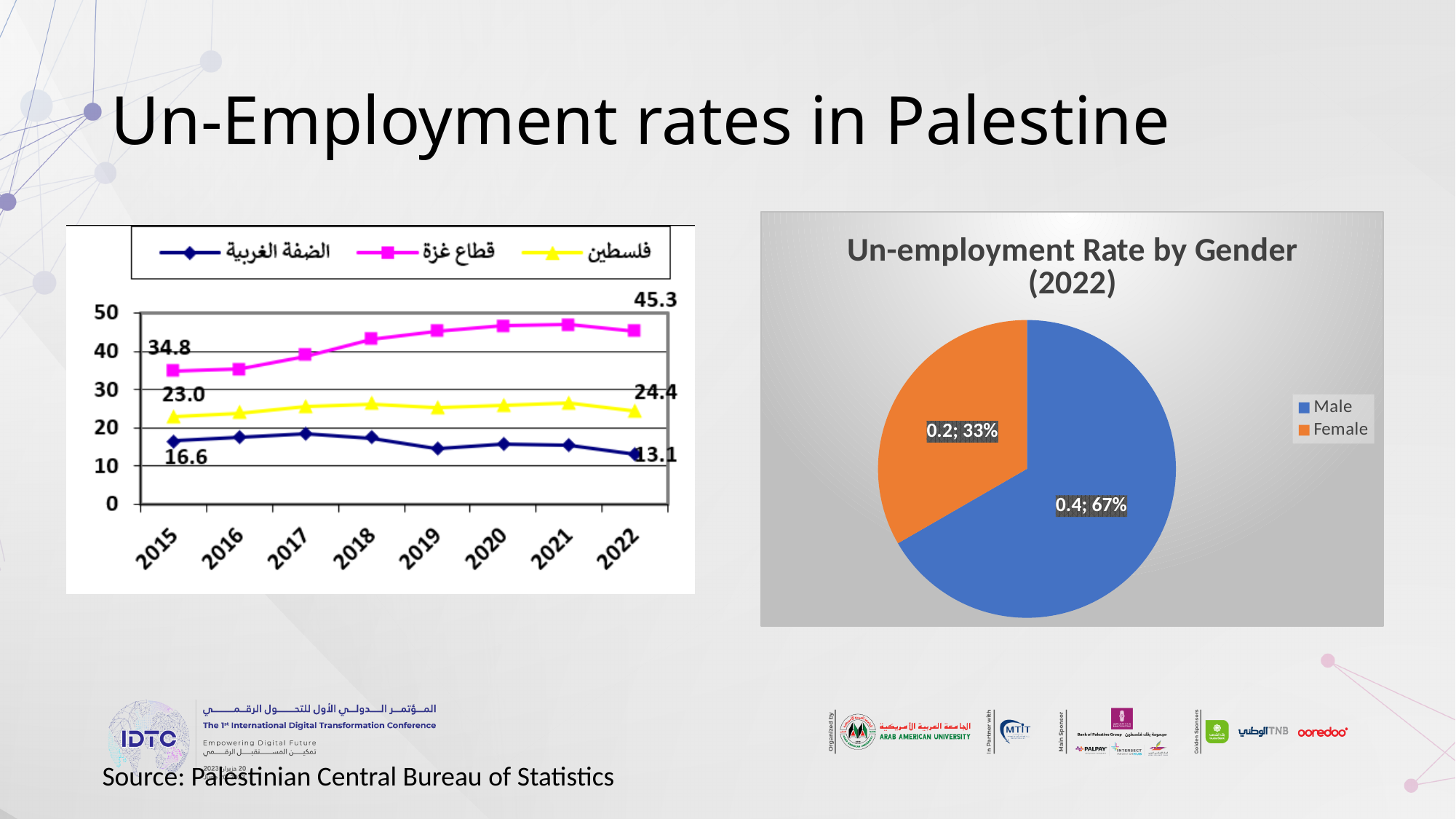
In the line chart on the left, how many series does the legend list? 3 In the line chart on the left, what value is labelled for the magenta square series (قطاع غزة) in 2022? 45.3 In the line chart on the left, does the navy diamond series (الضفة الغربية) rise or fall between 2015 and 2022? fall In the line chart on the left, how many years are shown on the x axis? 8 In the pie chart 'Un-employment Rate by Gender (2022)', which slice is larger, Male or Female? Male In the line chart on the left, which series has the highest values across all years? قطاع غزة (magenta squares) In the pie chart 'Un-employment Rate by Gender (2022)', what share of the pie is Female? 33% In the line chart on the left, what value is labelled for the navy diamond series (الضفة الغربية) in 2015? 16.6 In the line chart on the left, is the value for the yellow triangle series (فلسطين) in 2018 greater or less than 20? greater In the line chart on the left, by how much did the magenta square series (قطاع غزة) change from its 2015 label of 34.8 to its 2022 label of 45.3? 10.5 In the line chart on the left, what value is labelled for the yellow triangle series (فلسطين) in 2022? 24.4 In the line chart on the left, what value is labelled for the magenta square series (قطاع غزة) in 2015? 34.8